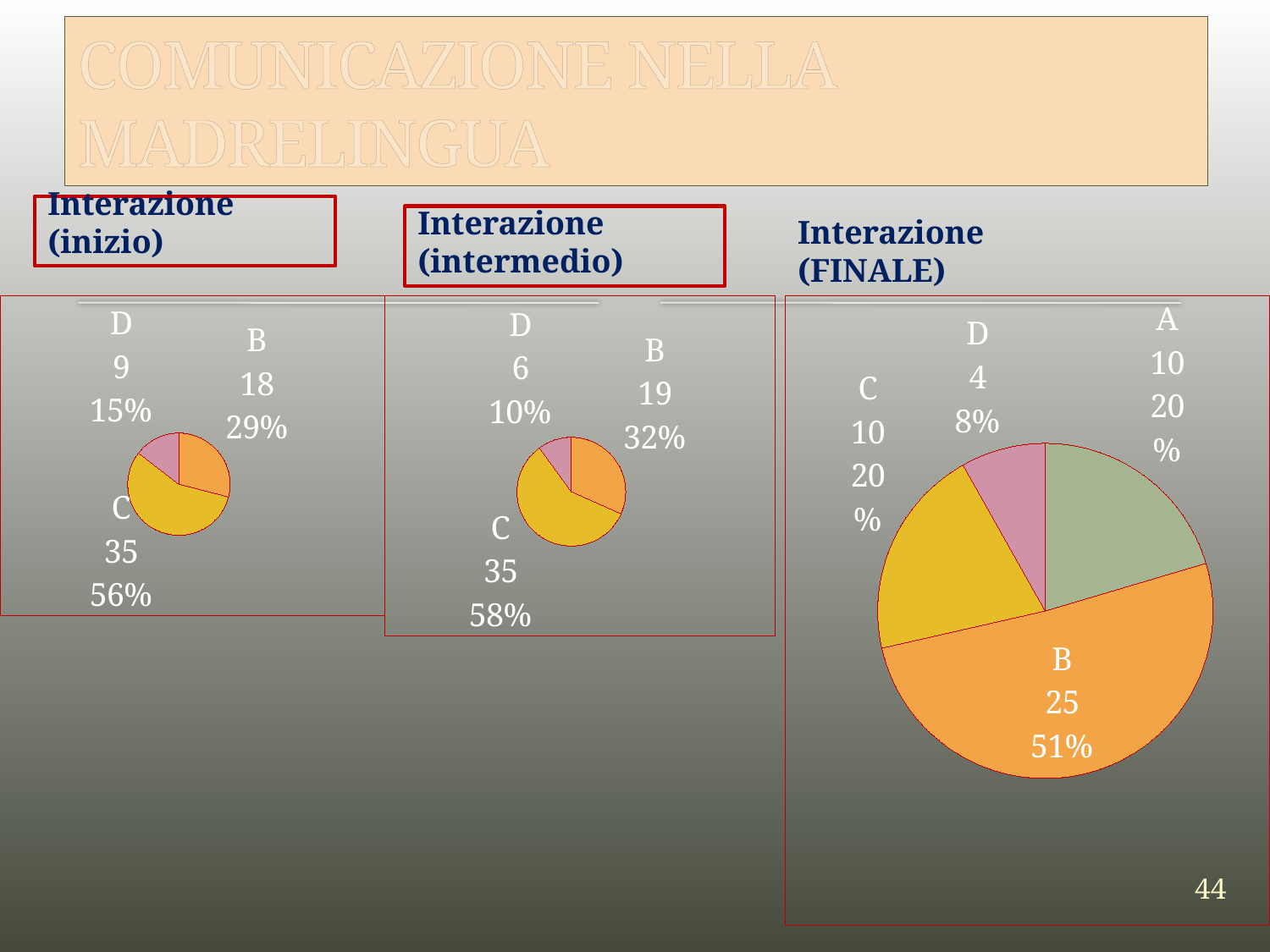
How many slices does the Interazione (FINALE) pie chart have? 4 What is the title of the chart on the right of the slide? Interazione (FINALE) In the Interazione (intermedio) chart, what share of the pie does C have? 58% In the Interazione (inizio) chart, which category has the smallest slice? D In the Interazione (FINALE) chart, what share of the pie does D have? 8% In the Interazione (FINALE) chart, is the value for B larger than the value for C? Yes In the Interazione (intermedio) chart, what is the difference between the values for C and B? 16 In the Interazione (intermedio) chart, what is the value for D? 6 What kind of chart is used for Interazione (inizio)? pie chart In the Interazione (FINALE) chart, which category has the largest slice? B In the Interazione (inizio) chart, what share of the pie does B have? 29% In the Interazione (inizio) chart, what is the value for C? 35